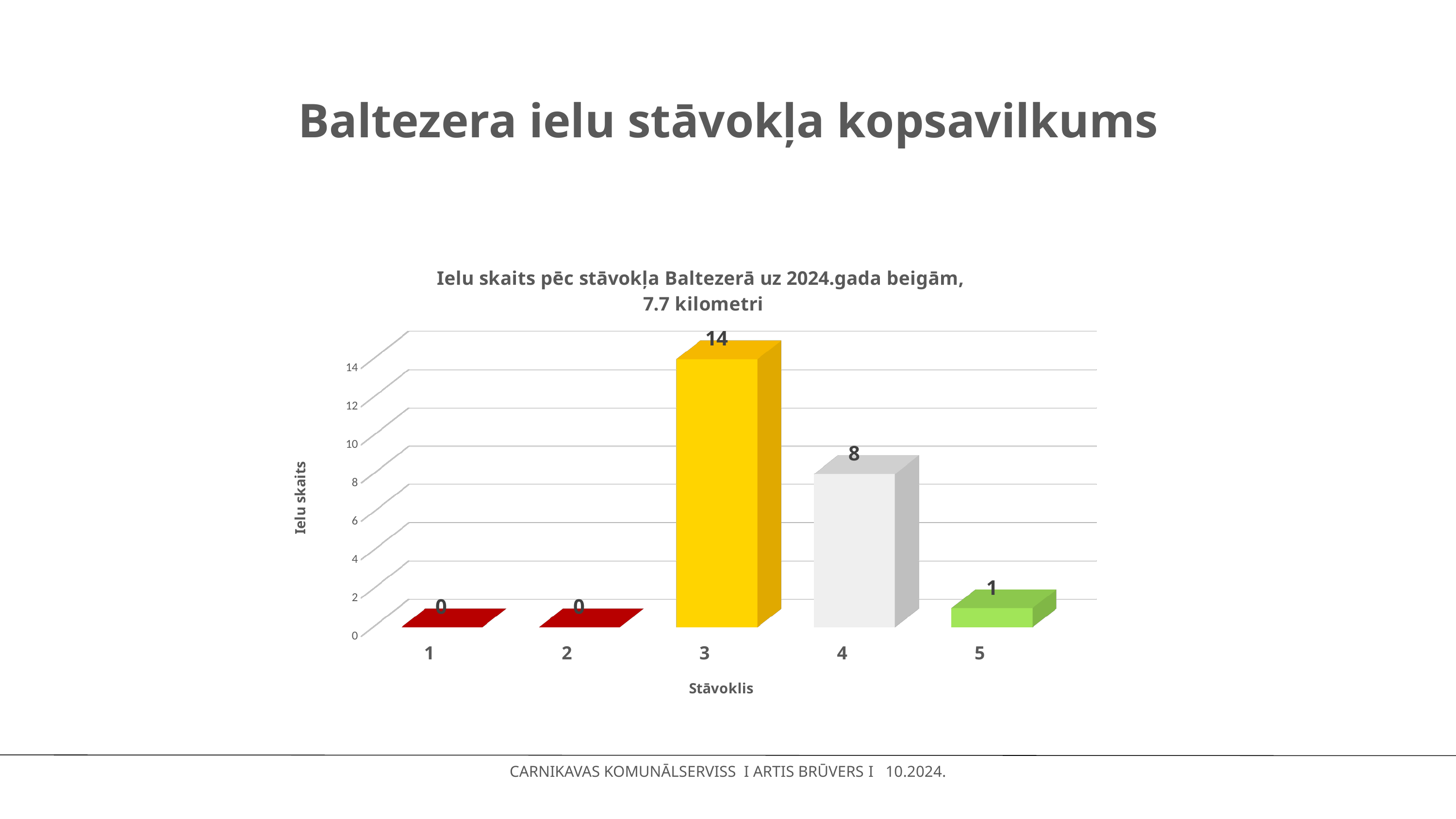
Which is larger, the value for category 4 or the value for category 5? 4 What is the label of the y axis? Ielu skaits What is the label of the x axis? Stāvoklis What kind of chart is shown on the slide? bar chart How many categories are shown on the x axis? 5 What is the difference between the values for categories 3 and 4? 6 Which category has the highest value? 3 What is the value for category 5? 1 What is the value for category 1? 0 What is the value for category 3? 14 Is the value for category 3 greater or less than 10? greater What is the value for category 4? 8